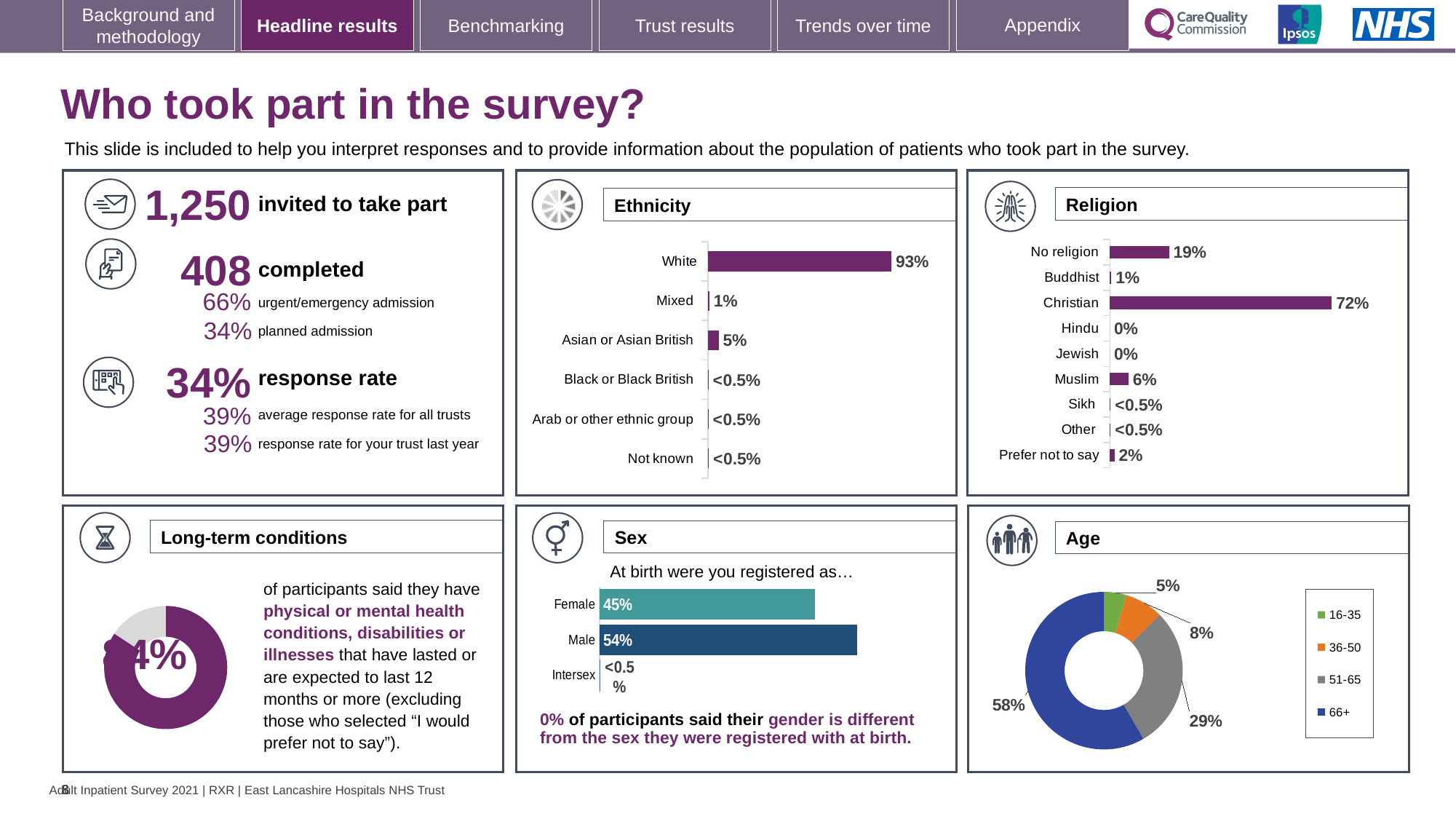
In the Religion chart, what percentage of respondents were Christian? 72% In the Religion chart, what is the difference between the Christian and No religion values? 53% How many categories are shown in the Religion chart? 9 In the Ethnicity chart, what percentage of respondents were White? 93% In the Ethnicity chart, what is the value for Asian or Asian British? 5% How many age groups does the legend of the Age chart list? 4 In the Religion chart, which is larger, Muslim or Prefer not to say? Muslim What kind of chart is the Age chart? Doughnut chart In the Sex chart, what percentage of respondents were registered as Male at birth? 54% In the Ethnicity chart, which ethnic group has the highest value? White In the Age chart, what share of respondents were aged 66+? 58% How many categories are shown in the Ethnicity chart? 6